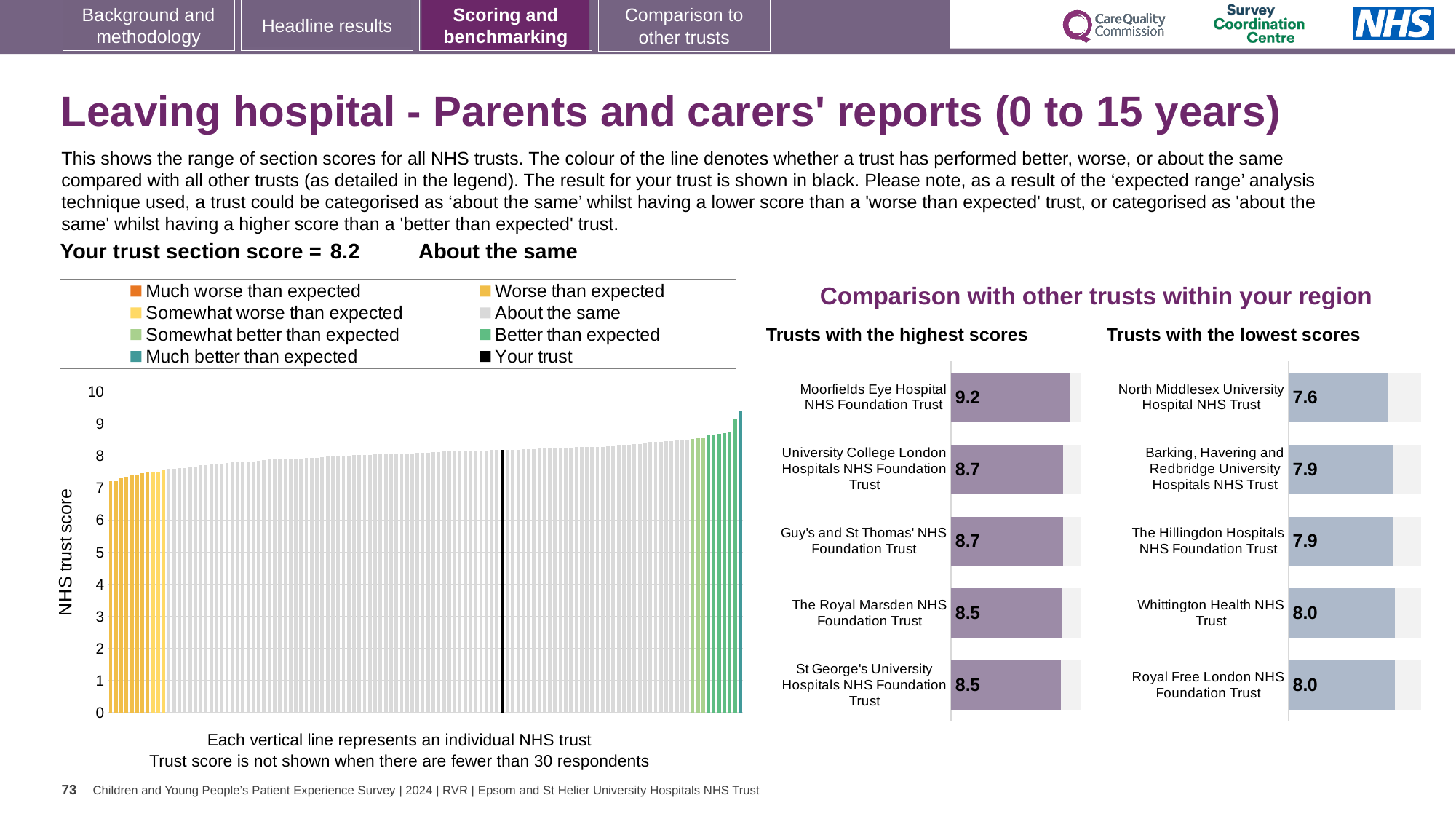
In the 'Trusts with the lowest scores' chart, what is the difference between the scores of Royal Free London NHS Foundation Trust and North Middlesex University Hospital NHS Trust? 0.4 In the main NHS trust score chart on the left, what is the section score for your trust (the black line)? 8.2 In the 'Trusts with the lowest scores' chart, which has the higher score: Whittington Health NHS Trust or The Hillingdon Hospitals NHS Foundation Trust? Whittington Health NHS Trust In the 'Trusts with the highest scores' chart, what is the score for Moorfields Eye Hospital NHS Foundation Trust? 9.2 In the 'Trusts with the lowest scores' chart, which trust has the lowest score? North Middlesex University Hospital NHS Trust In the 'Trusts with the highest scores' chart, which trust has the highest score? Moorfields Eye Hospital NHS Foundation Trust In the 'Trusts with the highest scores' chart, what is the score for The Royal Marsden NHS Foundation Trust? 8.5 How many trusts are shown in the 'Trusts with the highest scores' chart? 5 In the 'Trusts with the lowest scores' chart, what is the score for North Middlesex University Hospital NHS Trust? 7.6 How many entries does the legend of the main NHS trust score chart list? 8 In the 'Trusts with the highest scores' chart, what is the difference between the scores of Moorfields Eye Hospital NHS Foundation Trust and The Royal Marsden NHS Foundation Trust? 0.7 In the main NHS trust score chart on the left, do the trust scores rise or fall from left to right? rise